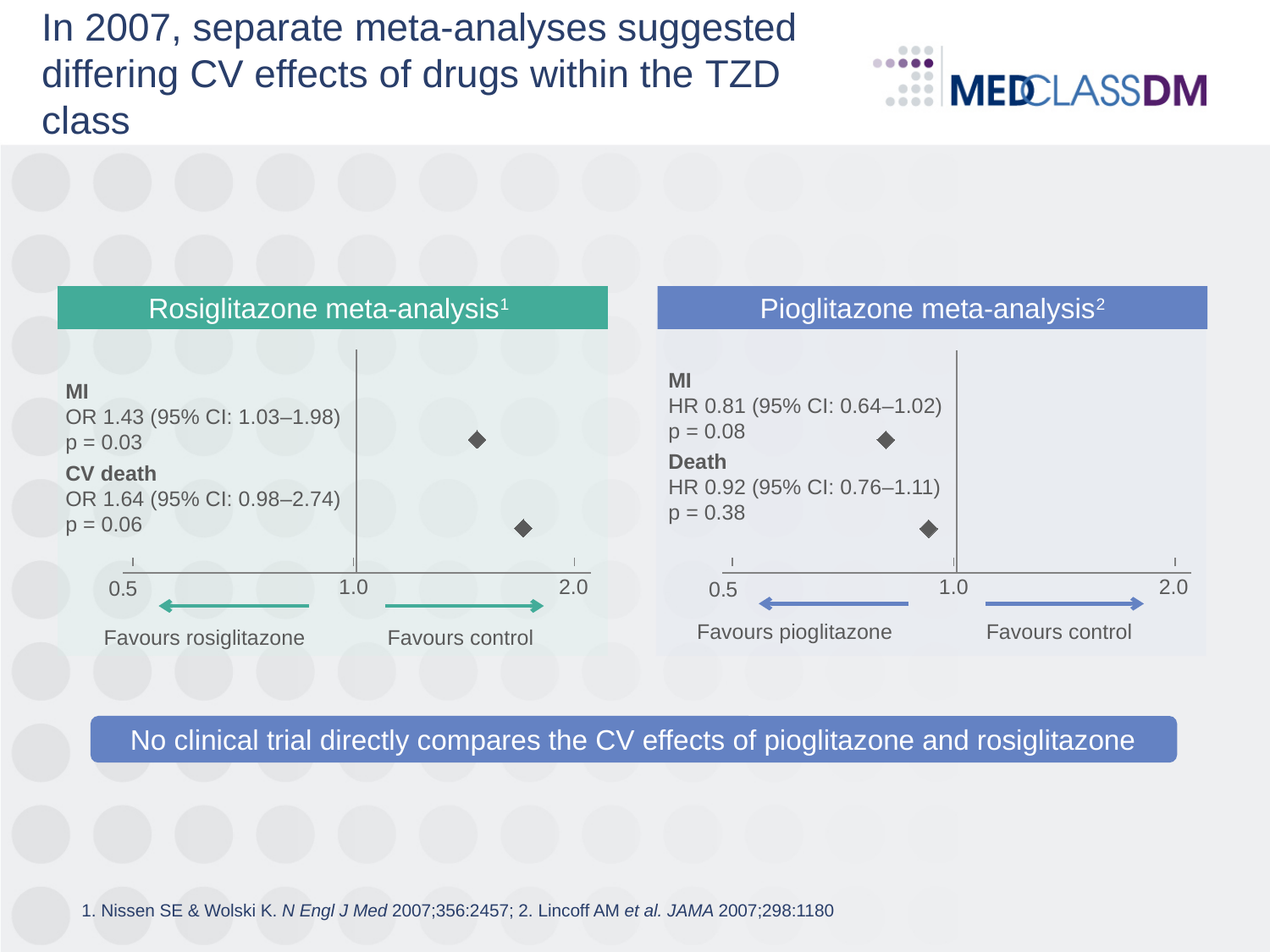
In the Rosiglitazone meta-analysis chart, what is the odds ratio for MI? 1.43 In the Rosiglitazone meta-analysis chart, which outcome has the higher odds ratio, MI or CV death? CV death In the Rosiglitazone meta-analysis chart, what is the p-value for MI? p = 0.03 In the Pioglitazone meta-analysis chart, is the hazard ratio for MI greater or less than 1.0? less In the Pioglitazone meta-analysis chart, what is the hazard ratio for Death? 0.92 How many outcomes are plotted in the Rosiglitazone meta-analysis chart? 2 In the Rosiglitazone meta-analysis chart, is the odds ratio for CV death greater or less than 1.0? greater In the Pioglitazone meta-analysis chart, what is the hazard ratio for MI? 0.81 In the Pioglitazone meta-analysis chart, what does the left-pointing arrow below the axis indicate? Favours pioglitazone In the Pioglitazone meta-analysis chart, what is the 95% confidence interval for the Death hazard ratio? 0.76–1.11 In the Rosiglitazone meta-analysis chart, what is the odds ratio for CV death? 1.64 In the Pioglitazone meta-analysis chart, which outcome has the lower hazard ratio? MI